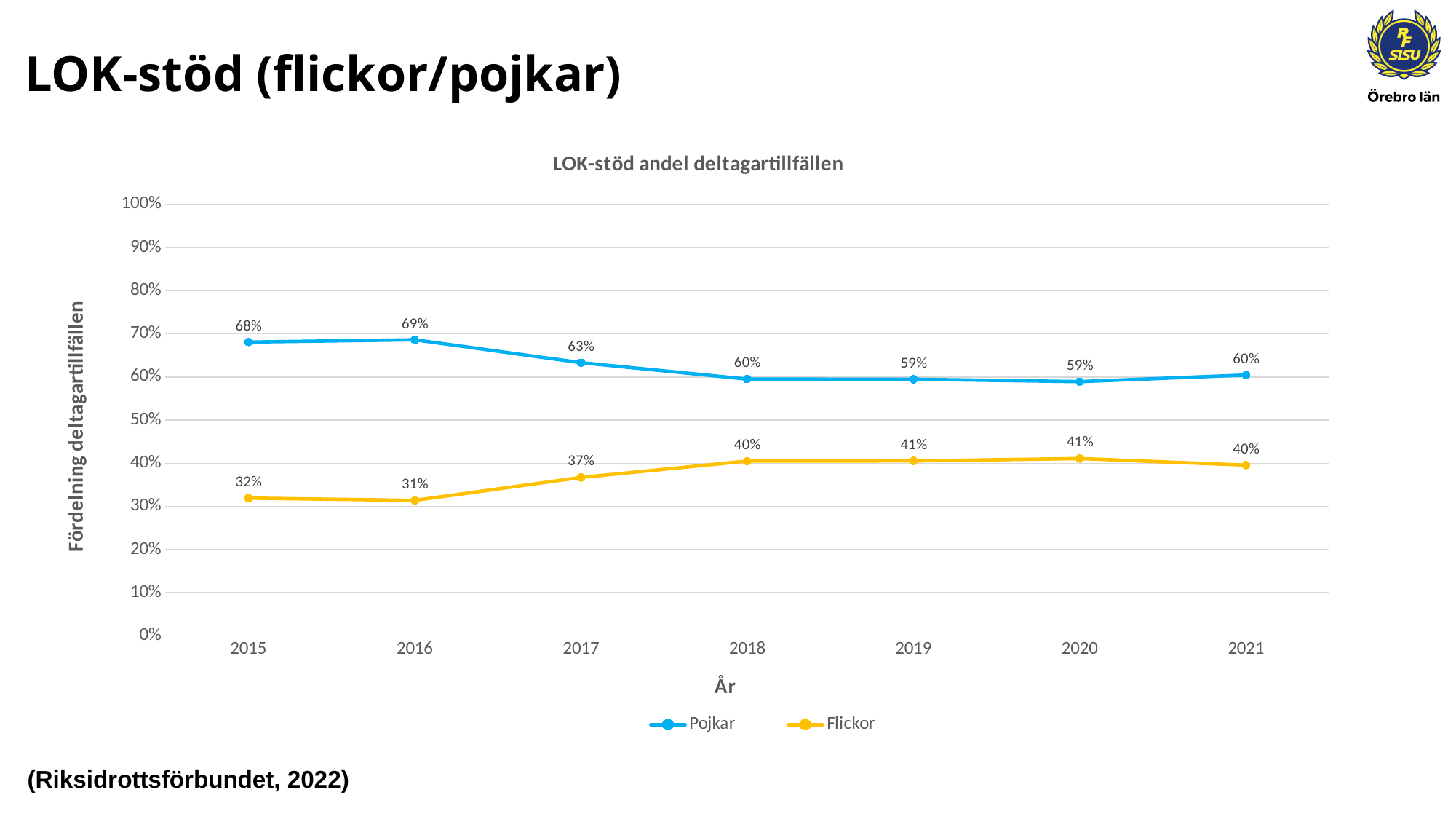
In which year is the Pojkar value highest? 2016 How many years are shown on the x axis? 7 What is the title of the chart? LOK-stöd andel deltagartillfällen What is the difference between the Pojkar and Flickor values in 2016? 38% How many series does the legend list? 2 What is the value for Flickor in 2021? 40% Does the Flickor series rise or fall from 2015 to 2021? Rise What is the value for Pojkar in 2015? 68% In which year is the Flickor value lowest? 2016 What kind of chart is shown? Line chart What is the value for Flickor in 2017? 37% Which series has the larger value in 2019, Pojkar or Flickor? Pojkar